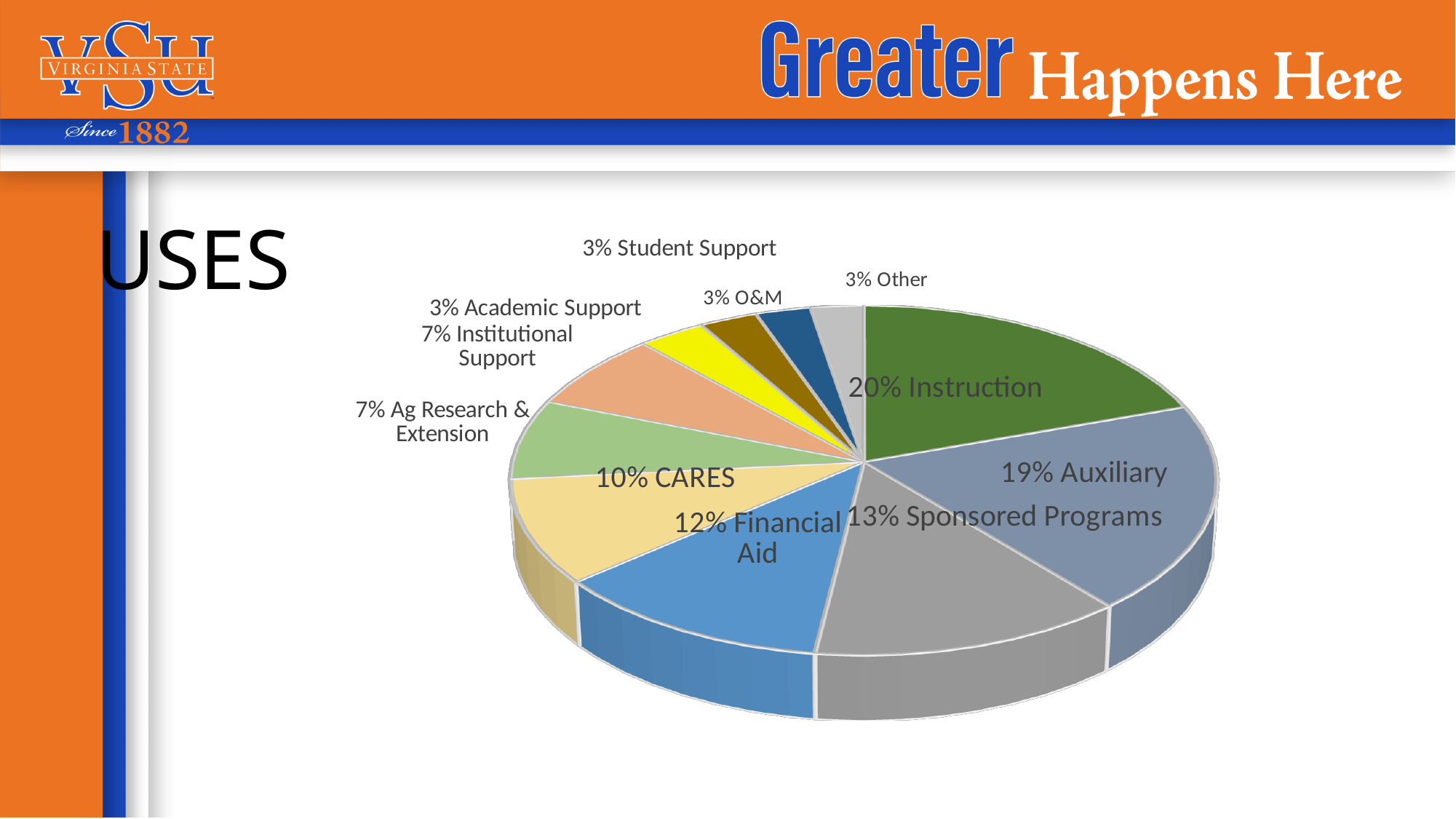
What is the title shown next to the pie chart? USES What share of the pie is Financial Aid? 12% Which category has the largest slice of the pie? Instruction What percentage is labelled for Sponsored Programs? 13% How many slices does the pie chart have? 11 What percentage is labelled for Auxiliary? 19% What kind of chart is shown on the slide? Pie chart What percentage is labelled for Ag Research & Extension? 7% Which is larger, the Auxiliary slice or the Sponsored Programs slice? Auxiliary What share of uses goes to Instruction? 20% What is the difference in percentage points between Instruction and Financial Aid? 8 What percentage is labelled for CARES? 10%